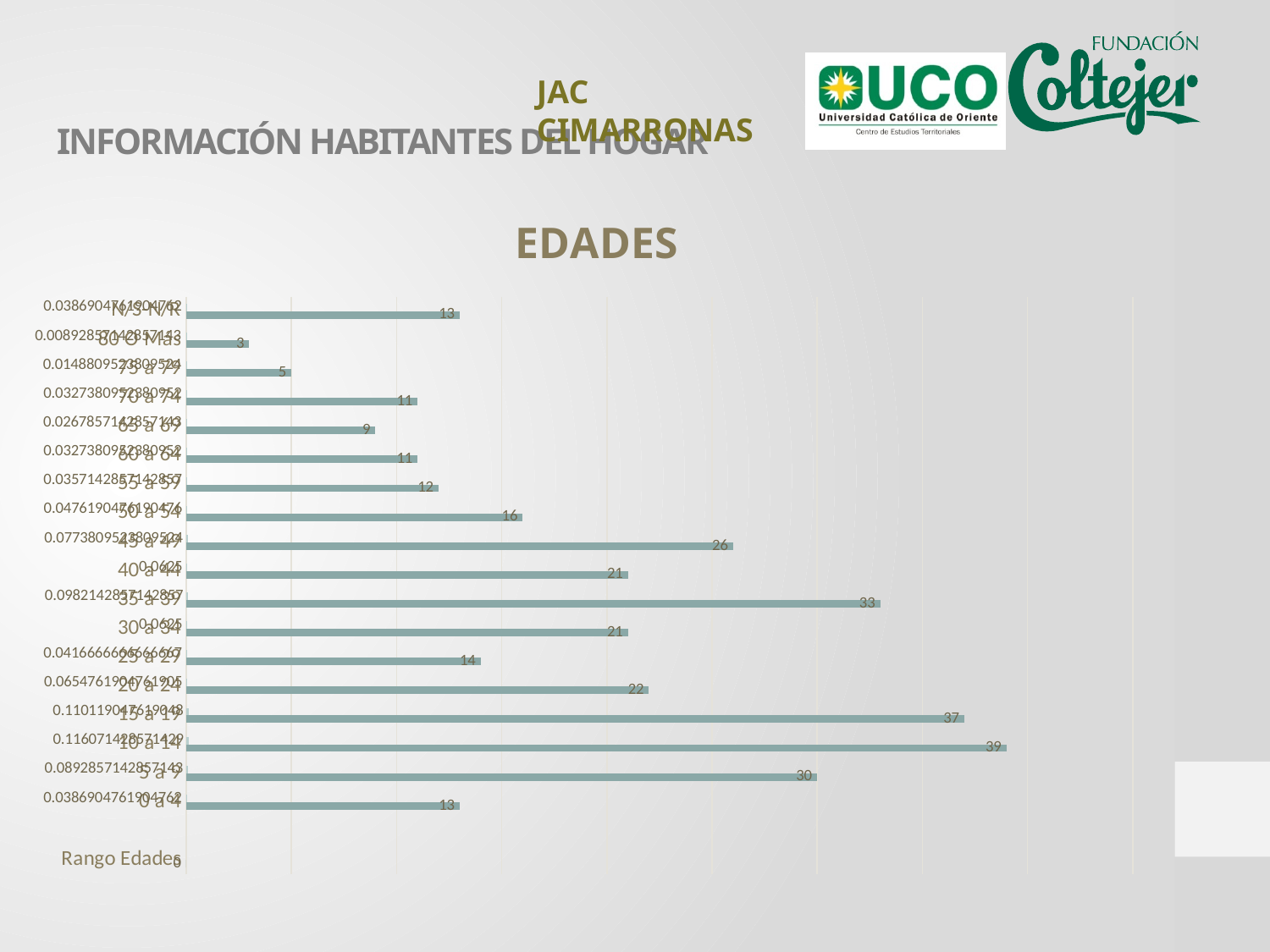
What kind of chart is shown under the title EDADES? bar chart Which age range has the highest value? 10 a 14 Which age range has the lowest non-zero value? 80 o más What is the value for the 80 o más age range? 3 What is the value for the 15 a 19 age range? 37 Which is larger, the value for 45 a 49 or the value for 50 a 54? 45 a 49 What is the value for the 35 a 39 age range? 33 What is the value for the 10 a 14 age range? 39 What is the difference between the values for 10 a 14 and 15 a 19? 2 What is the value for the 5 a 9 age range? 30 What is the difference between the values for 35 a 39 and 30 a 34? 12 What is the title of the chart? EDADES